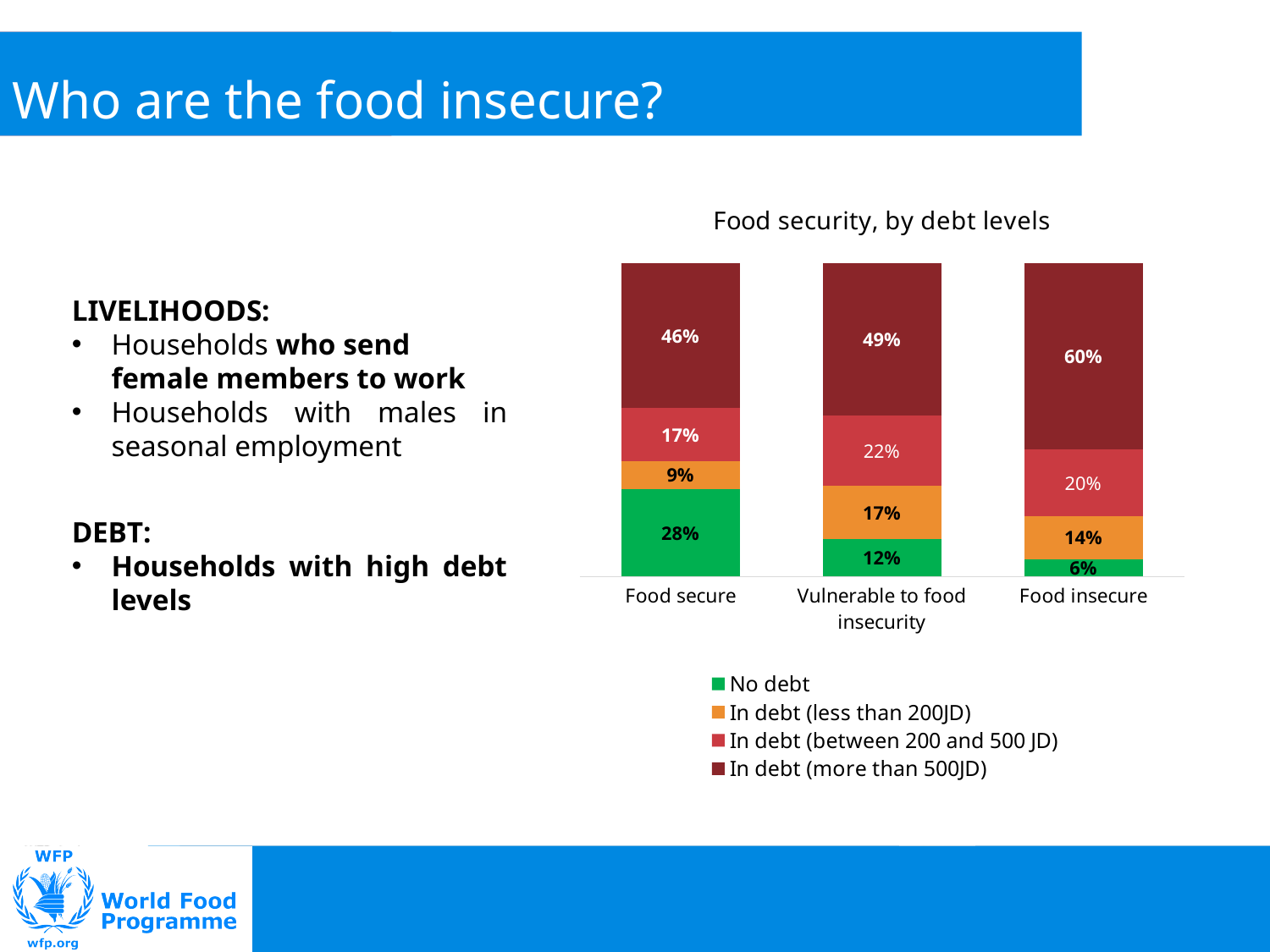
What percentage of Food secure households have no debt? 28% What type of chart is shown on the slide? Stacked bar chart Which is larger: the In debt (less than 200JD) share for Vulnerable to food insecurity or for Food insecure? Vulnerable to food insecurity Which category has the highest share of households with no debt? Food secure What is the difference between the In debt (more than 500JD) share for Food insecure and Food secure households? 14% What percentage of Food insecure households are in debt (more than 500JD)? 60% How many series does the legend list? 4 What is the total of the stacked bar for Food secure? 100% How many categories are shown on the x axis? 3 Which category has the lowest share of households in debt (more than 500JD)? Food secure What is the title of the chart? Food security, by debt levels What is the value for In debt (between 200 and 500 JD) in the Vulnerable to food insecurity category? 22%